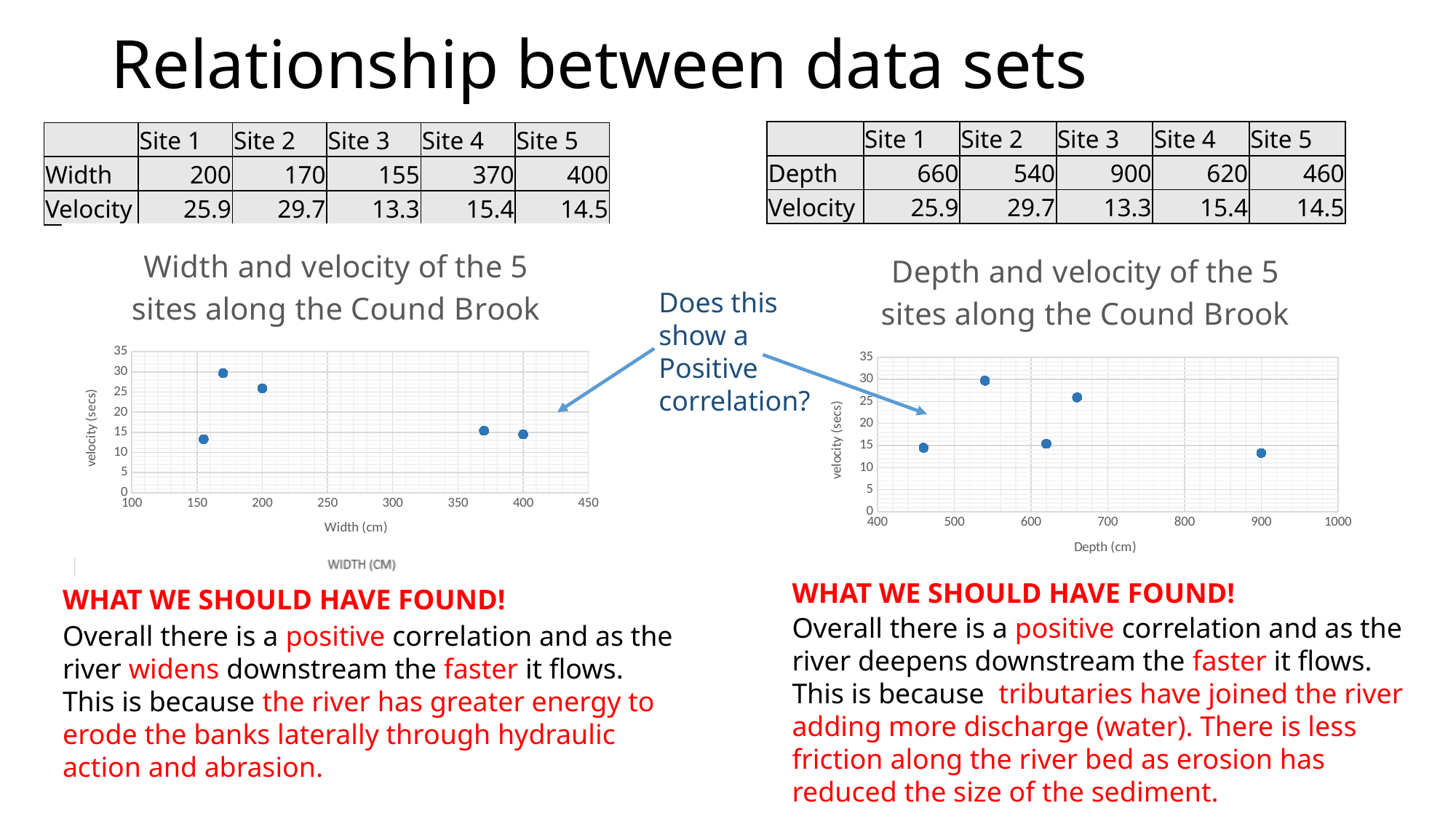
In the 'Width and velocity' chart, which has the higher velocity: the point at width 200 cm or the point at width 370 cm? Width 200 cm How many data points are plotted in the 'Depth and velocity of the 5 sites along the Cound Brook' chart? 5 What is the x-axis label of the 'Depth and velocity of the 5 sites along the Cound Brook' chart? Depth (cm) In the 'Depth and velocity' chart, is the velocity at a depth of 540 cm greater or less than 25? greater In the 'Width and velocity' chart, is the velocity at a width of 400 cm greater or less than 20? less In the 'Width and velocity' chart, what is the velocity at a width of 170 cm? 29.7 What is the y-axis label of the 'Width and velocity of the 5 sites along the Cound Brook' chart? velocity (secs) In the 'Width and velocity' chart, which site has the highest velocity? Site 2 What kind of chart is the 'Width and velocity of the 5 sites along the Cound Brook' chart? Scatter chart In the 'Depth and velocity' chart, at which depth is the lowest velocity plotted? 900 What is the difference between the velocity at Site 2 and the velocity at Site 3? 16.4 In the 'Depth and velocity' chart, what is the velocity at a depth of 900 cm? 13.3